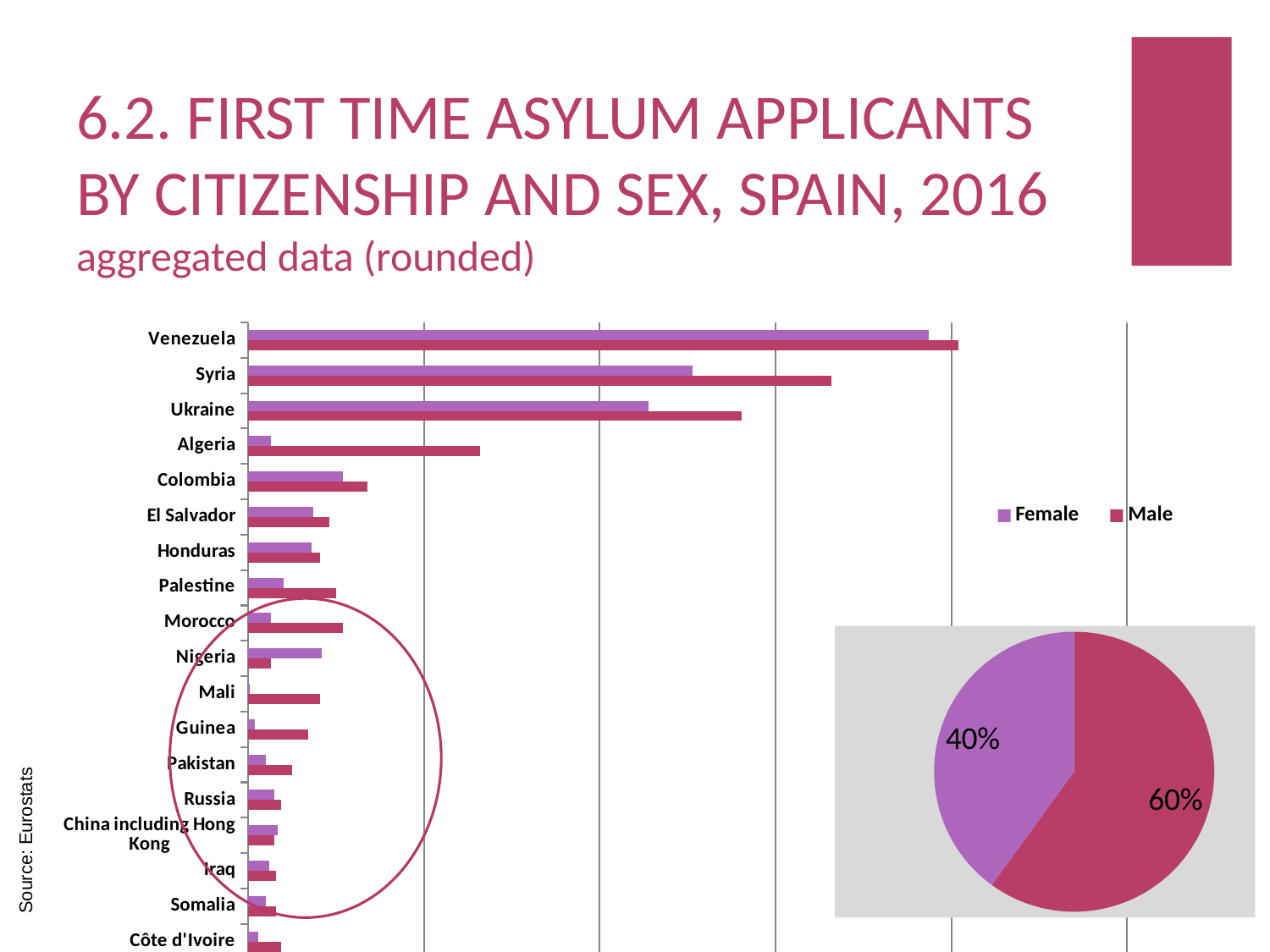
In the bar chart, which citizenship has the lowest number of female first-time asylum applicants? Mali In the bar chart, is the Male value for Syria larger or smaller than the Male value for Ukraine? Larger In the bar chart, for Algeria, is the Female value or the Male value larger? Male How many series does the legend of the bar chart list? 2 What kind of chart is the chart on the left of the slide? Bar chart In the bar chart, which citizenship has the highest number of male first-time asylum applicants? Venezuela In the pie chart, what share of first-time asylum applicants is male? 60% In the pie chart, what share of first-time asylum applicants is female? 40% In the bar chart, for Nigeria, is the Female value or the Male value larger? Female How many citizenship categories are shown in the bar chart? 18 In the bar chart, which citizenship has the highest number of female first-time asylum applicants? Venezuela In the pie chart, what is the difference in percentage points between the male and female shares? 20 percentage points